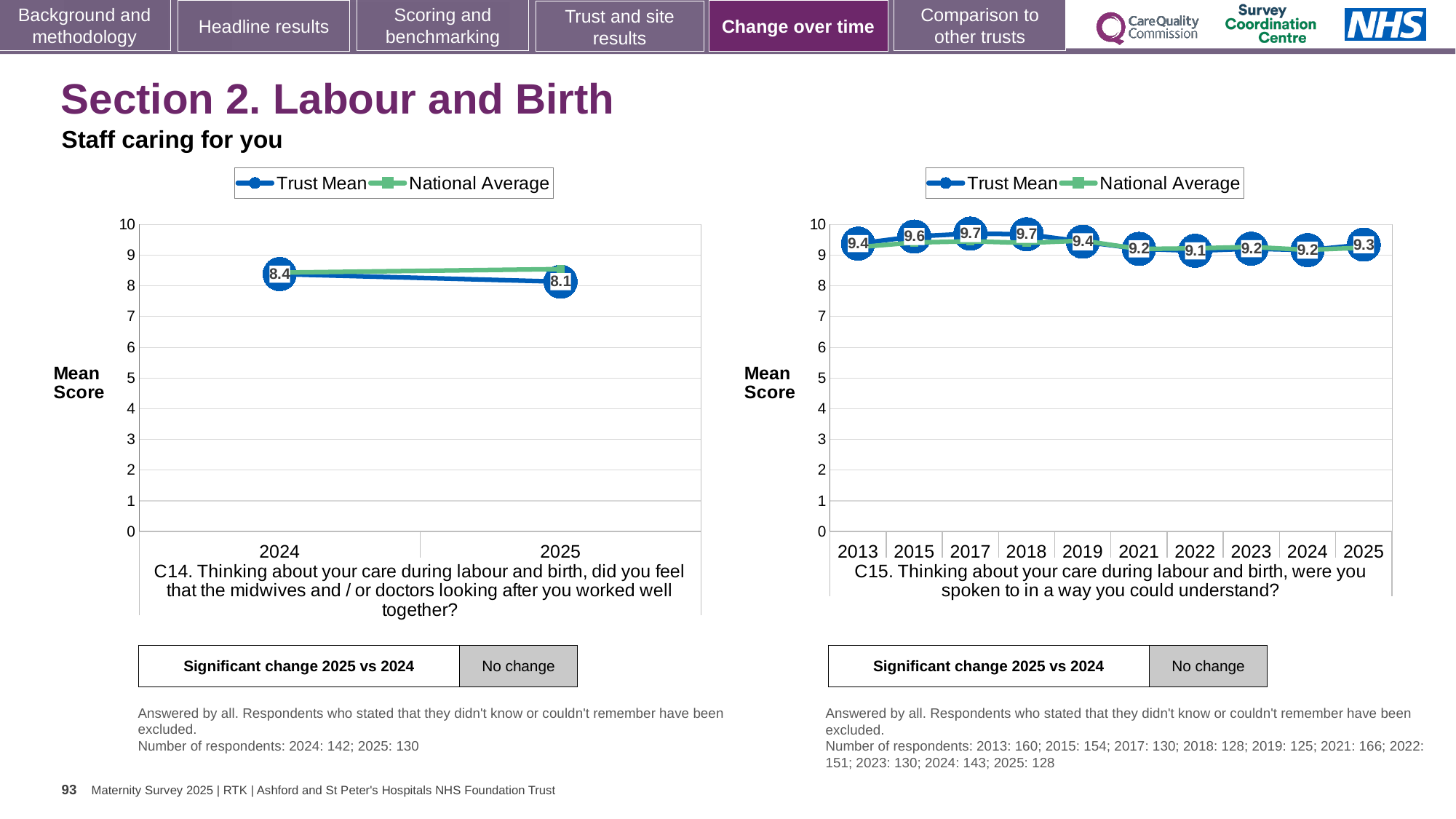
In the C15 chart on the right, what is the Trust Mean score for 2025? 9.3 How many series does the legend of the C14 chart on the left list? 2 In the C14 chart on the left, what is the Trust Mean score for 2024? 8.4 In the C15 chart on the right, what is the difference between the Trust Mean in 2017 and in 2022? 0.6 In the C15 chart on the right, which year has the lowest Trust Mean score? 2022 In the C15 chart on the right, what is the Trust Mean score for 2022? 9.1 In the C14 chart on the left, what is the Trust Mean score for 2025? 8.1 In the C15 chart on the right, is the Trust Mean for 2013 higher or lower than the Trust Mean for 2015? lower In the C14 chart on the left, does the Trust Mean rise or fall from 2024 to 2025? fall In the C15 chart on the right, how many years are plotted on the x axis? 10 What type of chart is the C15 chart on the right? line chart In the C14 chart on the left, by how much did the Trust Mean fall from 2024 to 2025? 0.3